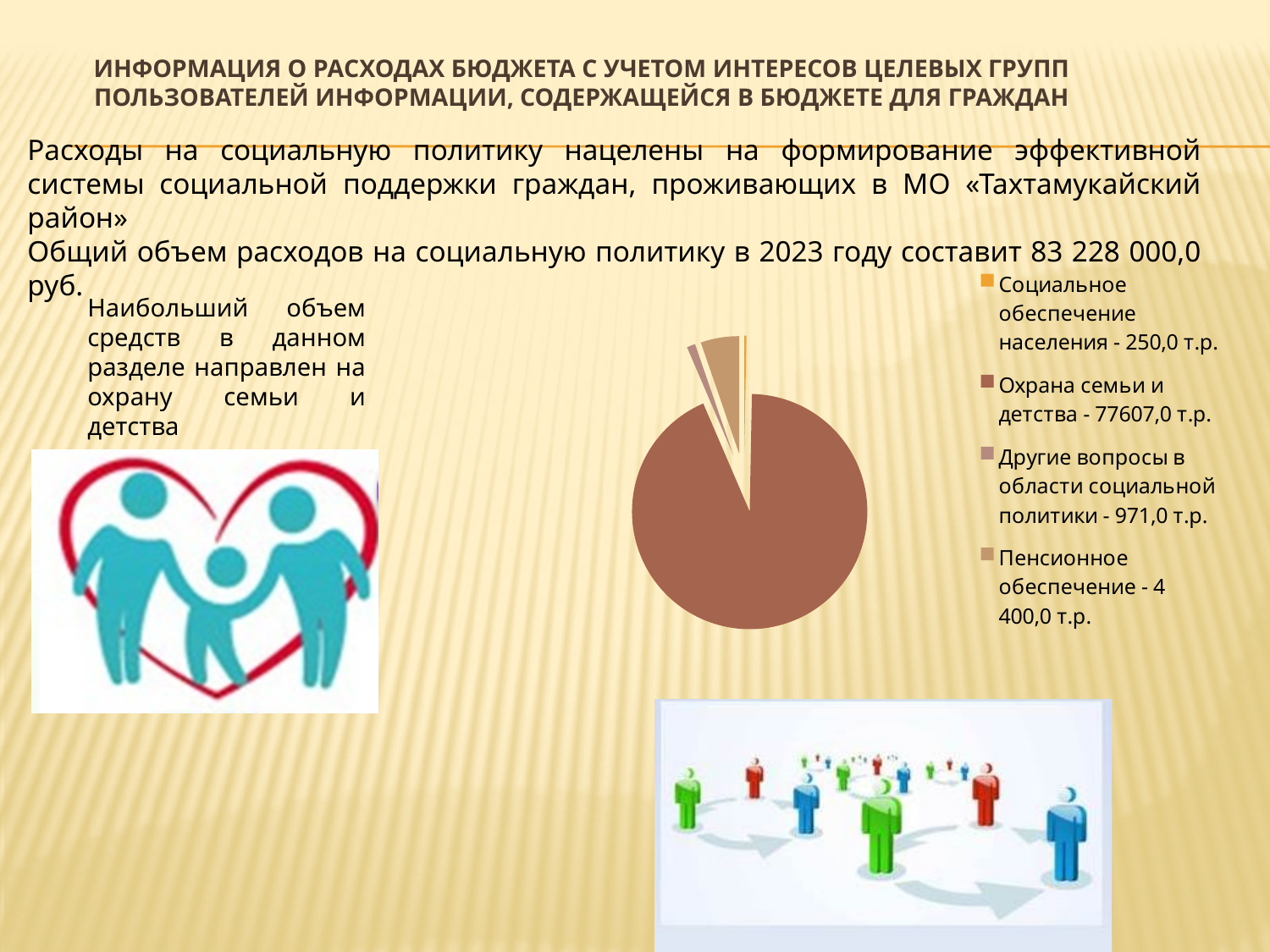
How many categories does the pie chart show? 4 Which category has the smallest slice of the pie chart? Социальное обеспечение населения What is the difference between Другие вопросы в области социальной политики and Социальное обеспечение населения? 721,0 т.р. What is the value for Пенсионное обеспечение in the pie chart? 4 400,0 т.р. What is the value for Социальное обеспечение населения in the pie chart? 250,0 т.р. What is the value for Другие вопросы в области социальной политики in the pie chart? 971,0 т.р. Which category has the largest slice of the pie chart? Охрана семьи и детства What is the total of all four categories in the pie chart? 83228,0 т.р. What kind of chart is shown on the slide? Pie chart What is the value for Охрана семьи и детства in the pie chart? 77607,0 т.р. What is the difference between Охрана семьи и детства and Пенсионное обеспечение? 73207,0 т.р. Which is larger: Пенсионное обеспечение or Другие вопросы в области социальной политики? Пенсионное обеспечение